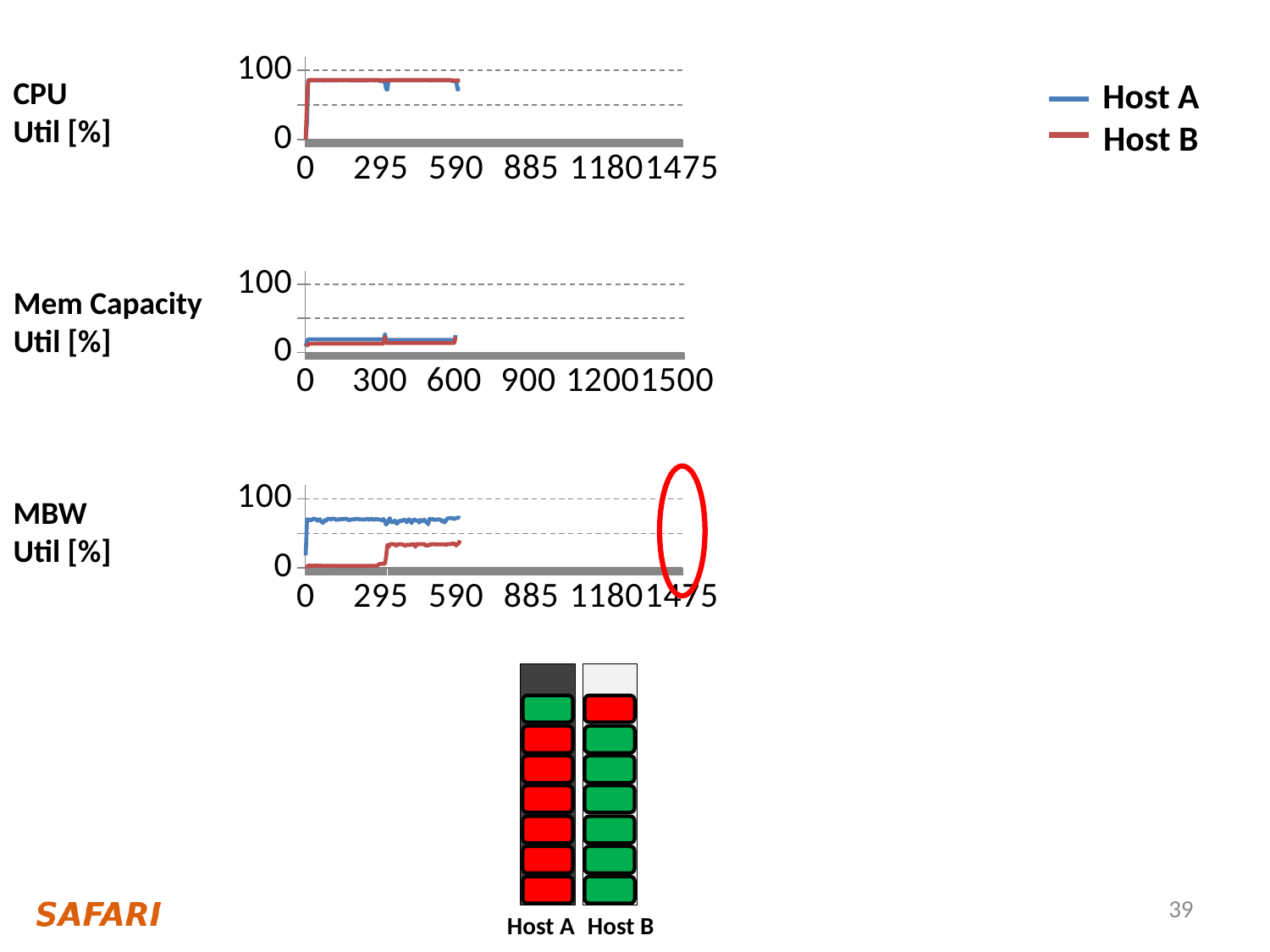
In the CPU Util [%] chart, is the value for Host B after the initial rise greater or less than 50? greater In the MBW Util [%] chart, which host has the higher utilization, Host A or Host B? Host A In the Mem Capacity Util [%] chart, is the value for Host A greater or less than 50? less Which series is drawn in blue in the legend? Host A How many series does the legend list? 2 In the MBW Util [%] chart, is the value for Host A greater or less than 50? greater What is the last x-axis tick label on the Mem Capacity Util [%] chart? 1500 In the MBW Util [%] chart, does the Host B line rise or fall after x = 295? rise What kind of chart is the CPU Util [%] chart? line chart What is the highest y-axis tick label shown on the Mem Capacity Util [%] chart? 100 Which series is drawn in red in the legend? Host B